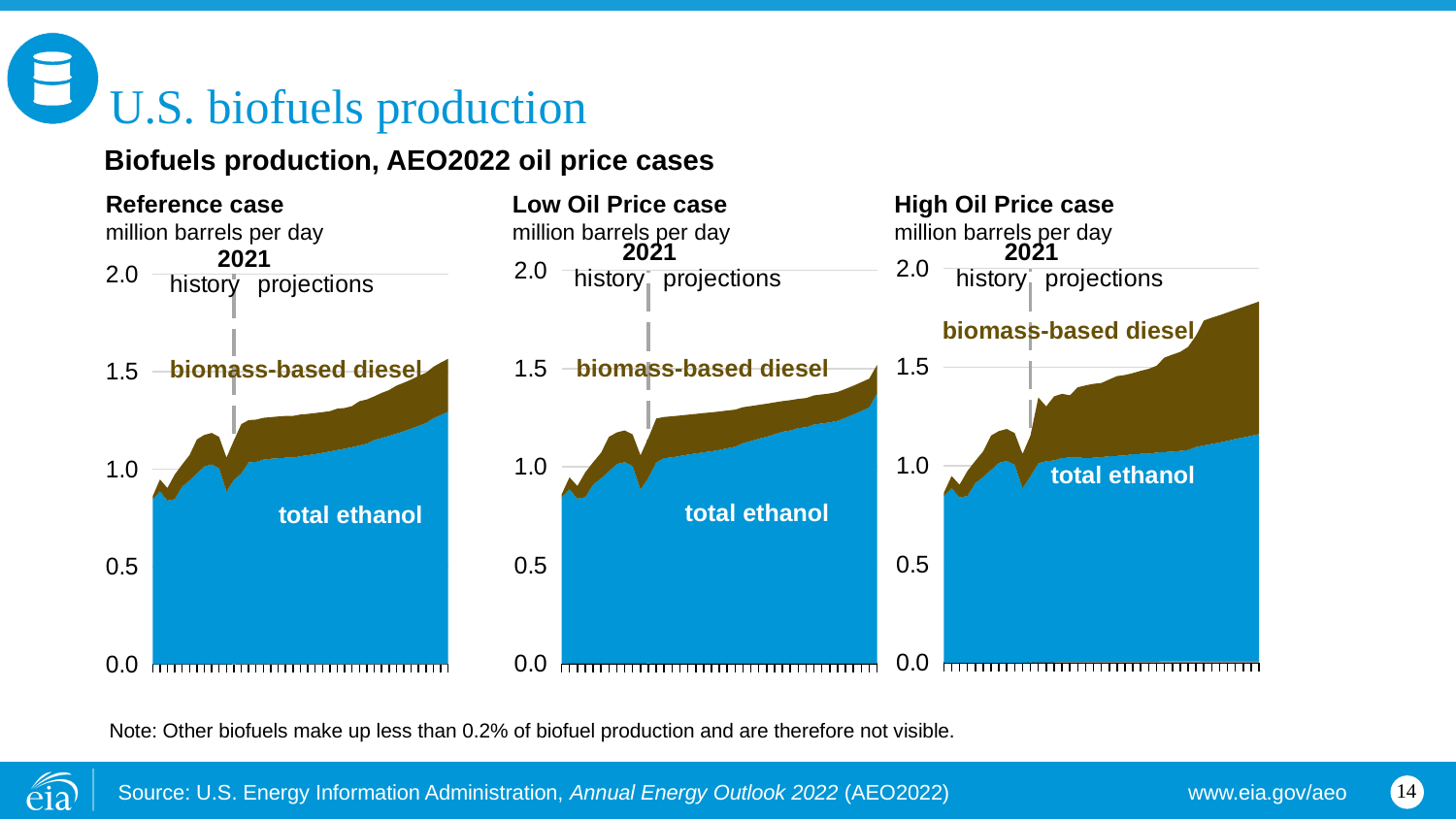
How many series are shown in each of the three charts? 2 In the Reference case chart, which series is larger at the end of the projection, total ethanol or biomass-based diesel? total ethanol What are the two series labelled in the Reference case chart? total ethanol and biomass-based diesel What kind of chart is used for the Reference case? stacked area chart In the Low Oil Price case chart, is total biofuels production at the start of the history period greater or less than 1.0? less In the Low Oil Price case chart, is total biofuels production at the end of the projection greater or less than 1.0? greater Which case shows higher total biofuels production at the end of the projection period, the High Oil Price case or the Low Oil Price case? High Oil Price case What year marks the boundary between history and projections in the charts? 2021 In the Reference case chart, is total ethanol production at the end of the projection greater or less than 1.0? greater What unit is used on the y axis of the three charts? million barrels per day In the High Oil Price case chart, does total biofuels production rise or fall over the projection period? rise